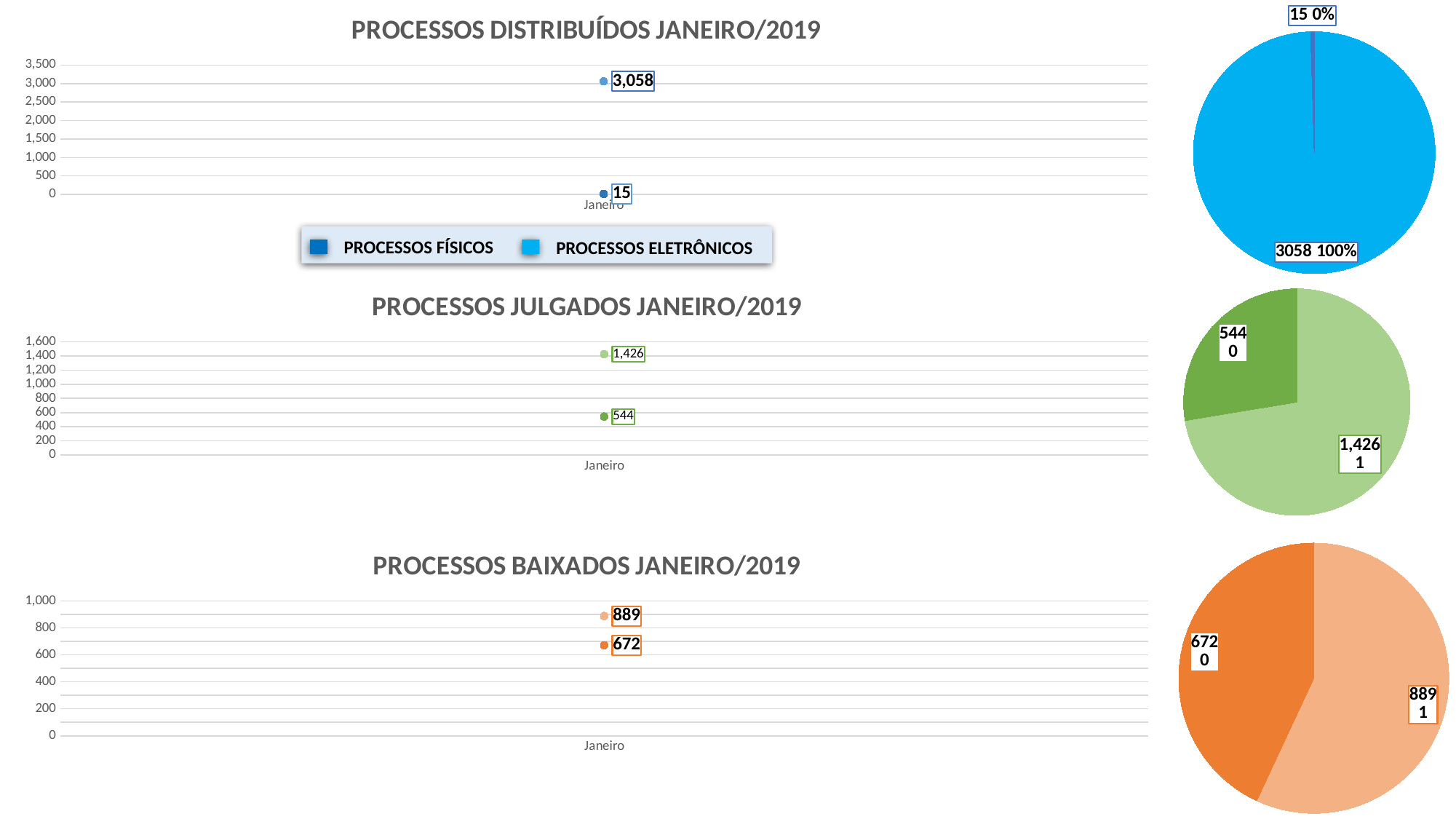
What is the category label on the x axis of the chart titled PROCESSOS JULGADOS JANEIRO/2019? Janeiro In the chart titled PROCESSOS DISTRIBUÍDOS JANEIRO/2019, how many series does the legend list? 2 In the chart titled PROCESSOS BAIXADOS JANEIRO/2019, what is the difference between the two plotted values, 889 and 672? 217 In the chart titled PROCESSOS JULGADOS JANEIRO/2019, what is the highest value shown? 1,426 In the chart titled PROCESSOS JULGADOS JANEIRO/2019, what is the difference between the two plotted values, 1,426 and 544? 882 In the pie chart at the top right of the slide, what share does the slice labelled 3058 have? 100% In the chart titled PROCESSOS DISTRIBUÍDOS JANEIRO/2019, what is the value for PROCESSOS FÍSICOS? 15 In the chart titled PROCESSOS DISTRIBUÍDOS JANEIRO/2019, what is the value for PROCESSOS ELETRÔNICOS? 3,058 In the chart titled PROCESSOS DISTRIBUÍDOS JANEIRO/2019, what is the difference between PROCESSOS ELETRÔNICOS and PROCESSOS FÍSICOS? 3,043 In the chart titled PROCESSOS DISTRIBUÍDOS JANEIRO/2019, which series has the larger value, PROCESSOS FÍSICOS or PROCESSOS ELETRÔNICOS? PROCESSOS ELETRÔNICOS In the chart titled PROCESSOS JULGADOS JANEIRO/2019, what is the lowest value shown? 544 In the chart titled PROCESSOS BAIXADOS JANEIRO/2019, what is the highest value shown? 889